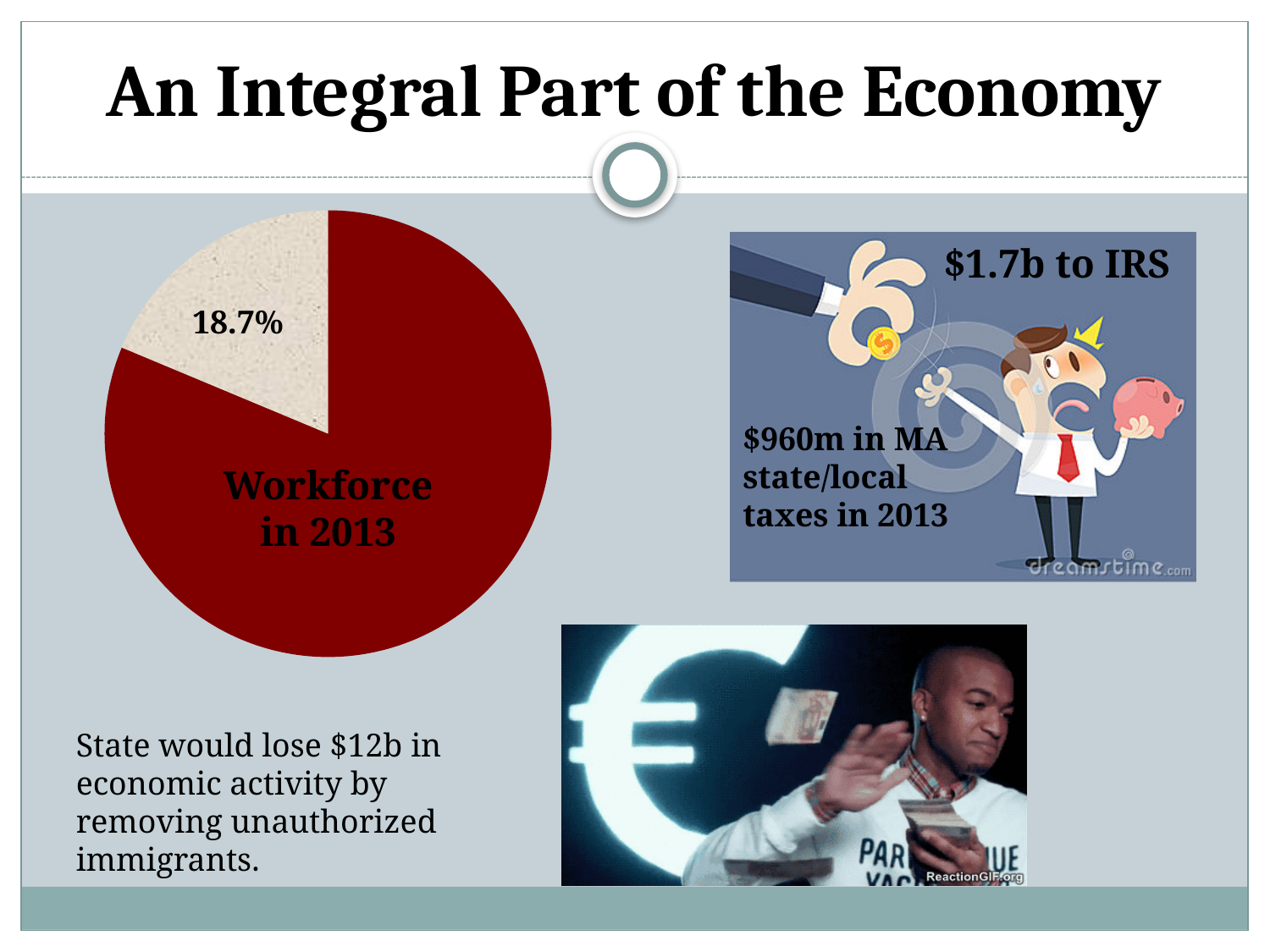
Which slice of the pie chart is larger, the beige slice or the dark red slice? the dark red slice What percentage is printed on the smaller (beige) slice of the pie chart? 18.7% Is the beige slice of the pie chart greater or less than 25% of the pie? less What colour is the larger slice of the pie chart? dark red How many slices does the pie chart have? 2 Is the dark red slice of the pie chart greater or less than 50% of the pie? greater What kind of chart is shown on the left of the slide? pie chart Which slice of the pie chart is the smallest? the beige slice labelled 18.7% What text label is printed inside the large dark red slice of the pie chart? Workforce in 2013